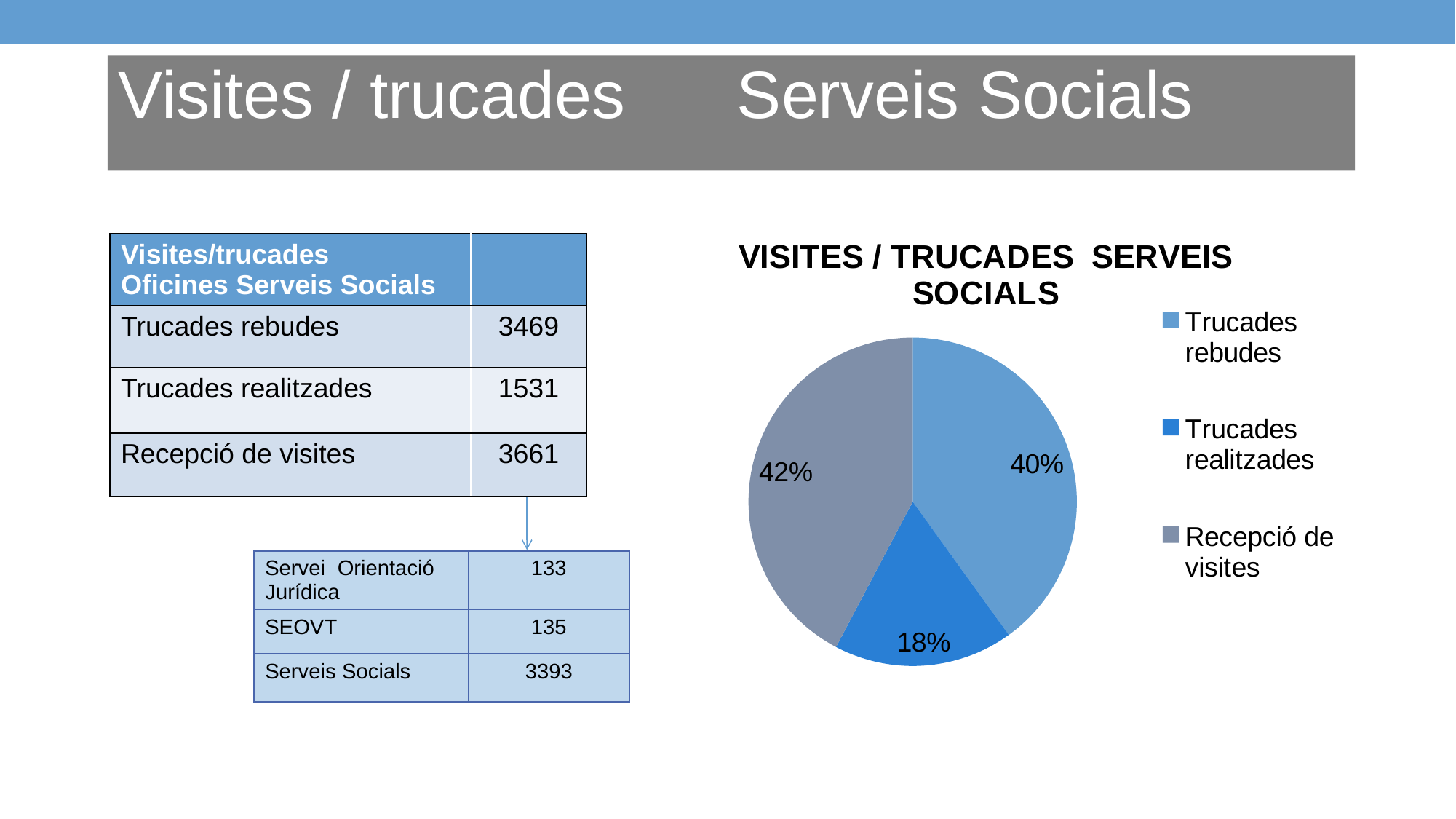
What is the difference in percentage points between the Recepció de visites slice and the Trucades realitzades slice? 24 Which slice is larger, Trucades rebudes or Trucades realitzades? Trucades rebudes What share of the pie does Trucades realitzades represent? 18% How many entries does the legend of the pie chart list? 3 What is the title of the pie chart? VISITES / TRUCADES SERVEIS SOCIALS What share of the pie does Trucades rebudes represent? 40% Which legend entry is shown in the darkest blue colour? Trucades realitzades How many slices does the pie chart have? 3 Which category has the smallest slice in the pie chart? Trucades realitzades Which category has the largest slice in the pie chart? Recepció de visites What share of the pie does Recepció de visites represent? 42% What kind of chart is shown on the slide? pie chart